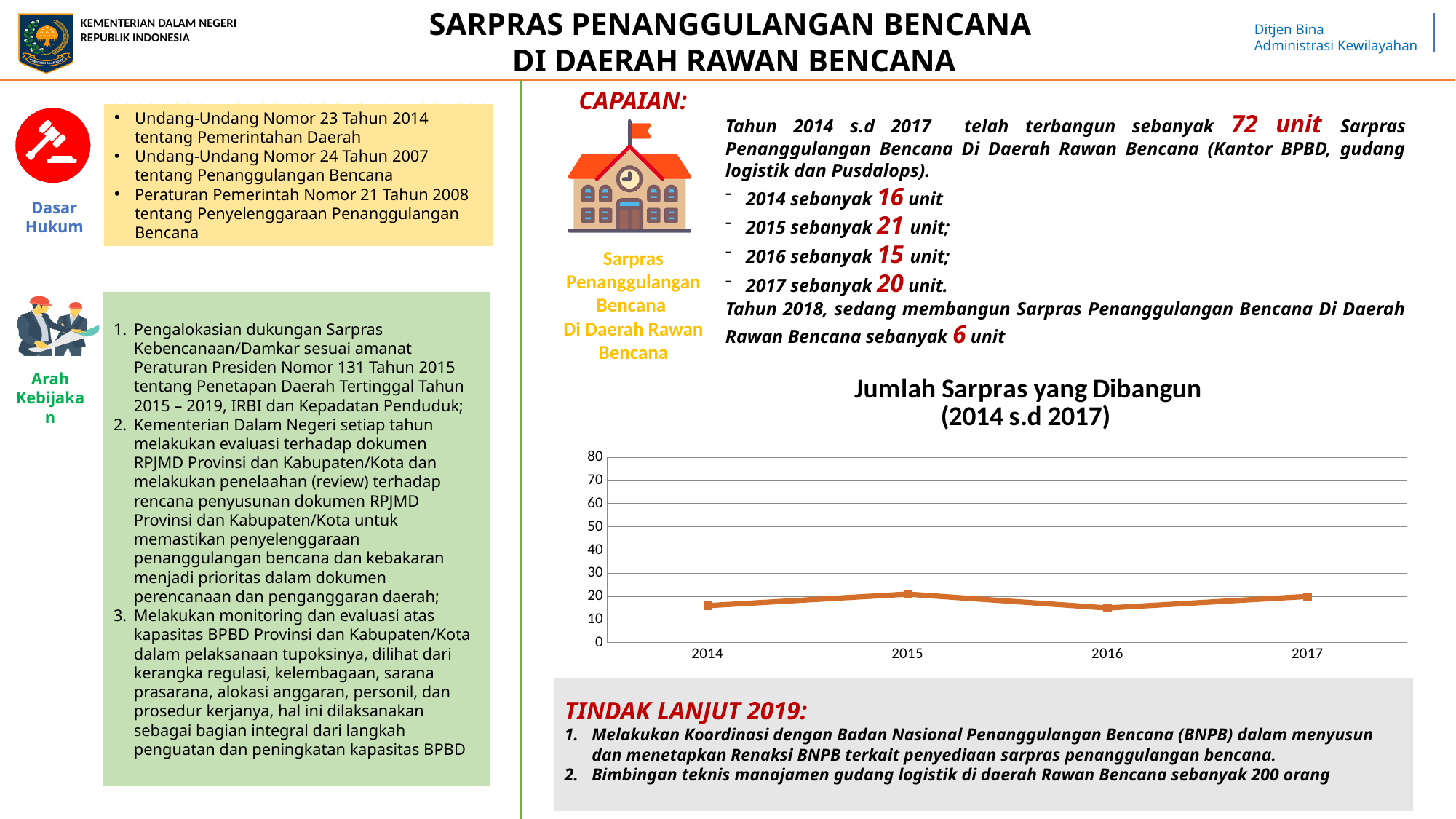
In the chart "Jumlah Sarpras yang Dibangun", is the value for 2016 greater or less than 20? less In the chart "Jumlah Sarpras yang Dibangun", which is larger, the value for 2017 or the value for 2016? 2017 In the chart "Jumlah Sarpras yang Dibangun", is the value for 2014 greater or less than 30? less In the chart "Jumlah Sarpras yang Dibangun", is the value for 2017 greater or less than 10? greater How many years are plotted on the x axis of the chart "Jumlah Sarpras yang Dibangun (2014 s.d 2017)"? 4 According to the slide, how many units of Sarpras were built in 2015, as plotted in the chart "Jumlah Sarpras yang Dibangun"? 21 What kind of chart is "Jumlah Sarpras yang Dibangun (2014 s.d 2017)"? line chart In the chart "Jumlah Sarpras yang Dibangun", which is larger, the value for 2015 or the value for 2016? 2015 What is the title of the chart on the slide? Jumlah Sarpras yang Dibangun (2014 s.d 2017) According to the slide, how many units of Sarpras were built in 2016, as plotted in the chart "Jumlah Sarpras yang Dibangun"? 15 What is the highest value shown on the y axis of the chart "Jumlah Sarpras yang Dibangun"? 80